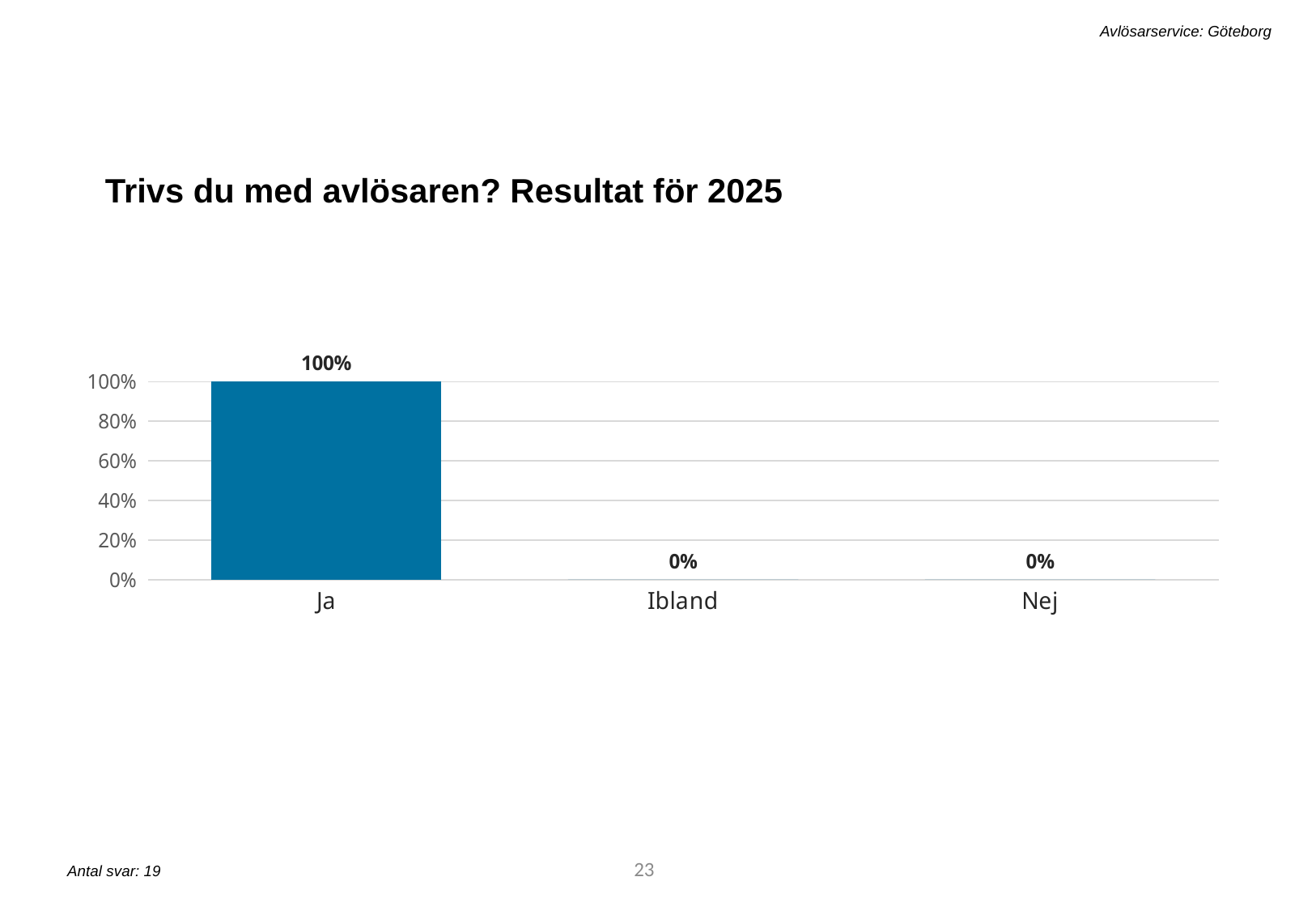
What is the value for Nej? 0% Do the values rise or fall from Ja to Nej along the x axis? fall Is the value for Ja greater or less than 80%? greater What is the title of the chart? Trivs du med avlösaren? Resultat för 2025 Which is larger, the value for Ja or the value for Ibland? Ja What is the value for Ja? 100% What is the difference between the values for Ja and Nej? 100% What kind of chart is shown on the slide? bar chart How many categories are shown on the x axis? 3 Which category has the highest value? Ja What is the value for Ibland? 0% What is the highest tick shown on the y axis? 100%